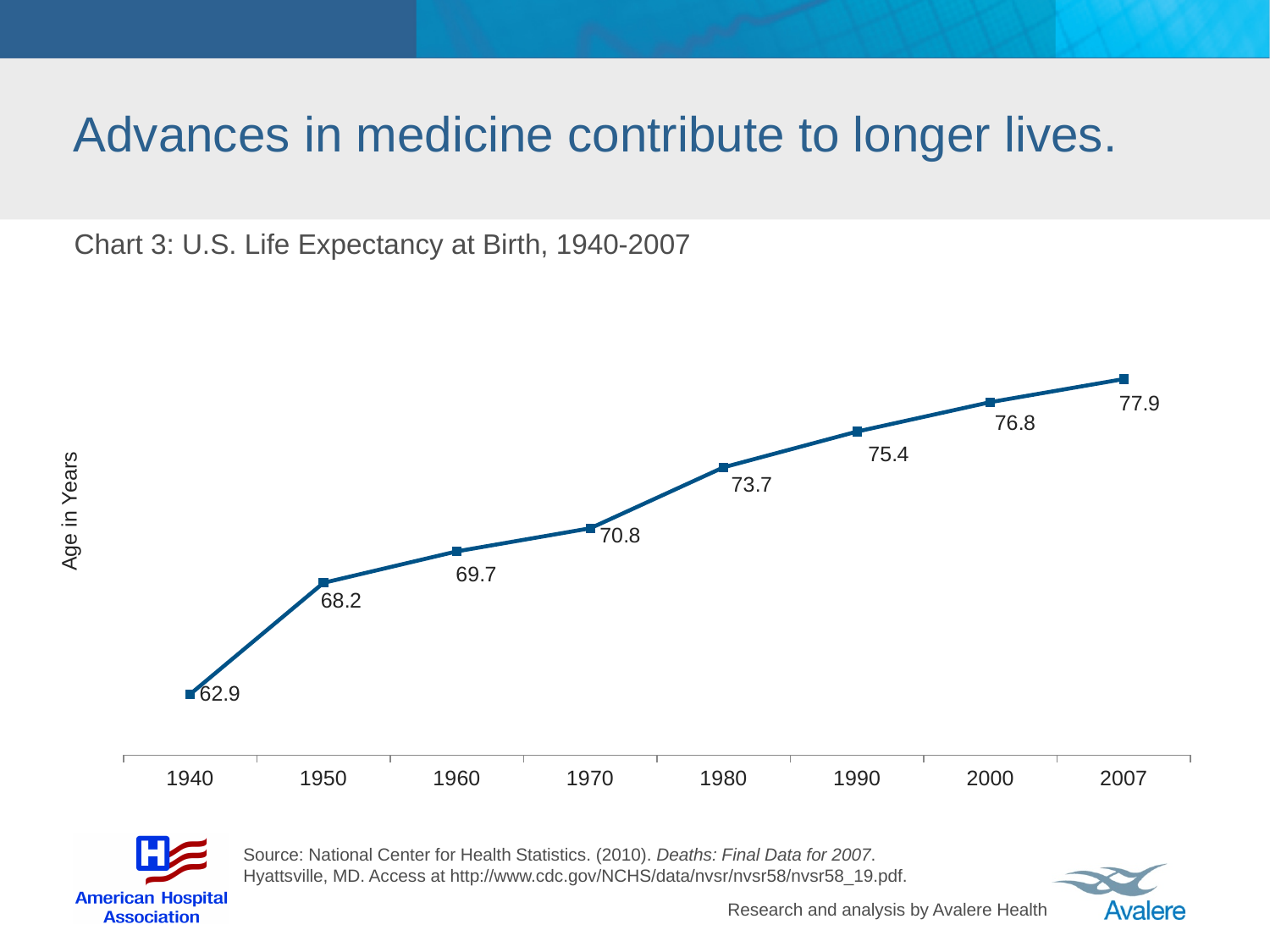
Which year has the highest life expectancy on the chart? 2007 How many data points are plotted on the chart? 8 What is the difference between the life expectancy values for 1950 and 1960? 1.5 What is the life expectancy value shown for 2007? 77.9 Which year has a higher life expectancy, 1970 or 1990? 1990 What is the U.S. life expectancy at birth shown for 1940? 62.9 What is the label on the vertical axis of the chart? Age in Years What kind of chart is shown on the slide? Line chart Which year has the lowest life expectancy on the chart? 1940 What is the life expectancy value shown for 1980? 73.7 Does life expectancy rise or fall from 1940 to 2007? Rise By how much did life expectancy increase from 1940 to 2007? 15.0